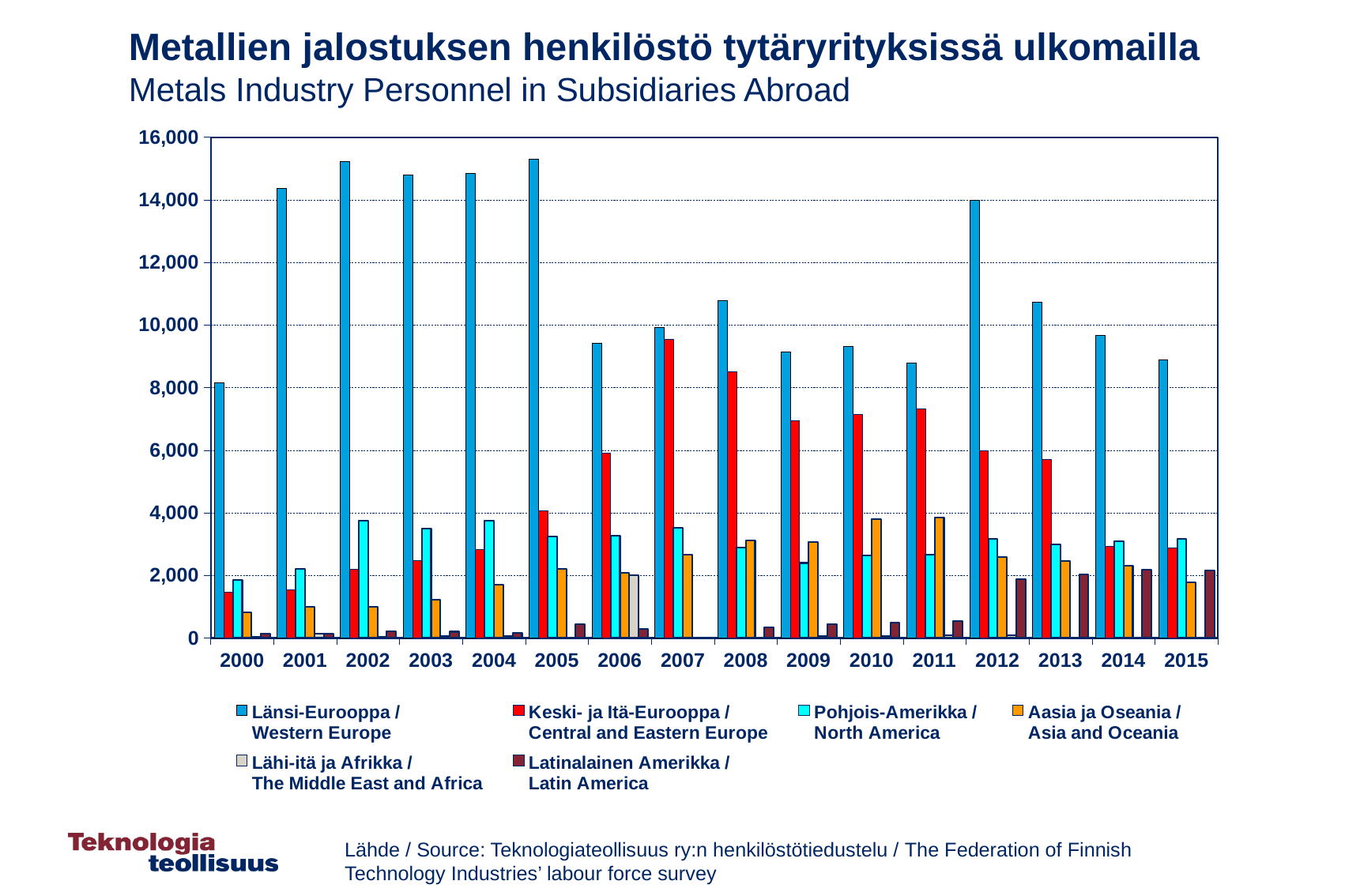
What kind of chart is shown on the slide? bar chart In which year is the value for Central and Eastern Europe highest? 2007 How many years are shown on the x axis? 16 Does the value for Central and Eastern Europe rise or fall from 2000 to 2007? rise Is the value for Western Europe in 2005 greater or less than 14,000? greater In 2010, which is larger: Asia and Oceania or North America? Asia and Oceania Is the value for Asia and Oceania in 2011 greater or less than 4,000? less Which series is shown in red? Keski- ja Itä-Eurooppa / Central and Eastern Europe Is the value for Central and Eastern Europe in 2007 greater or less than 8,000? greater How many series does the legend list? 6 In 2008, which is larger: Western Europe or Central and Eastern Europe? Western Europe